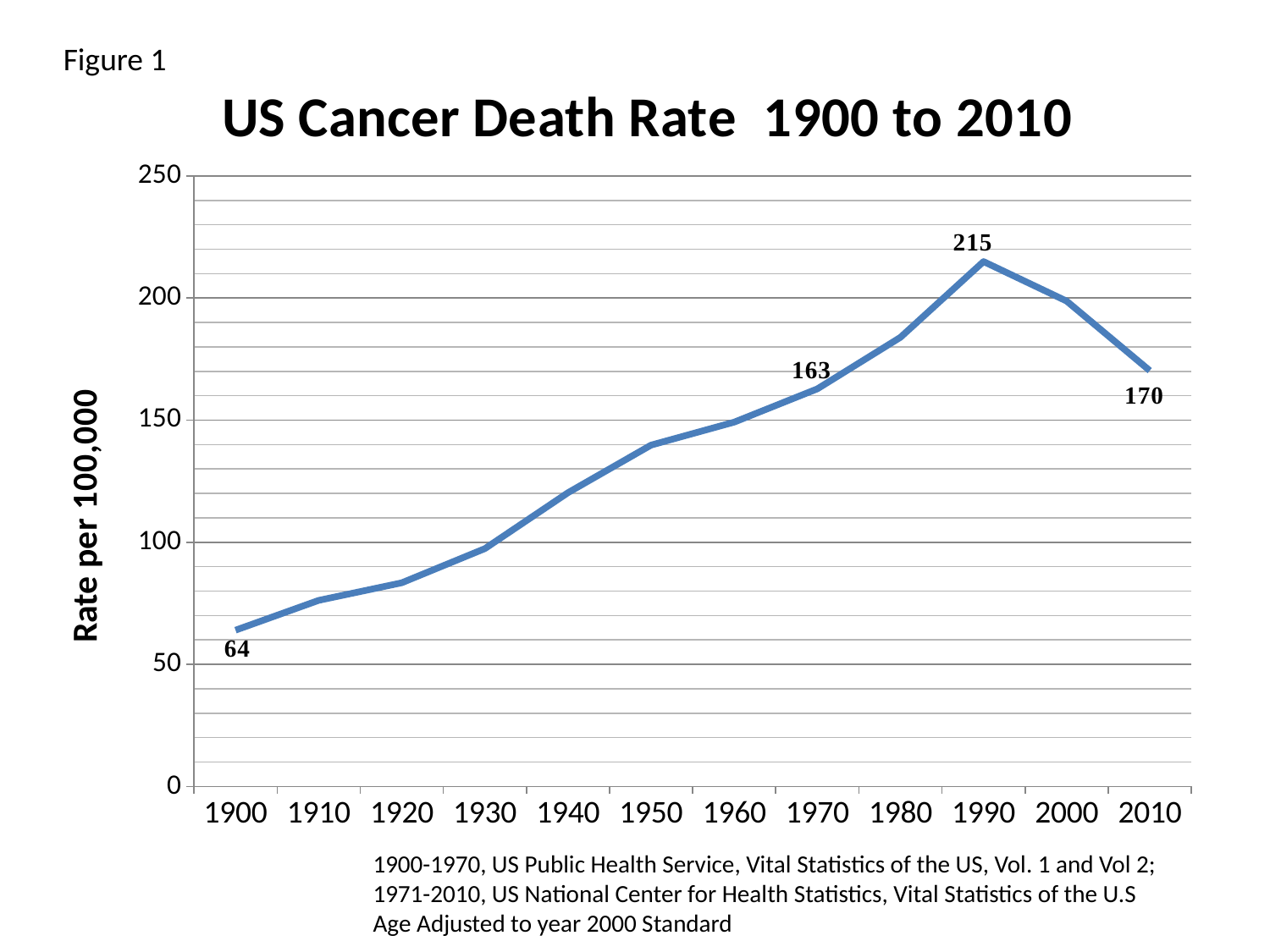
What is the cancer death rate per 100,000 in 2010? 170 Is the value for 1980 greater or less than 150? greater In which year is the cancer death rate lowest? 1900 What type of chart is shown on the slide? line chart What is the cancer death rate per 100,000 in 1990? 215 What is the title of the chart? US Cancer Death Rate 1900 to 2010 How many years are plotted on the x axis? 12 What is the difference between the cancer death rate in 1990 and in 2010? 45 Which year has a higher cancer death rate, 1970 or 2010? 2010 What is the cancer death rate per 100,000 in 1900? 64 What is the cancer death rate per 100,000 in 1970? 163 In which year is the cancer death rate highest? 1990